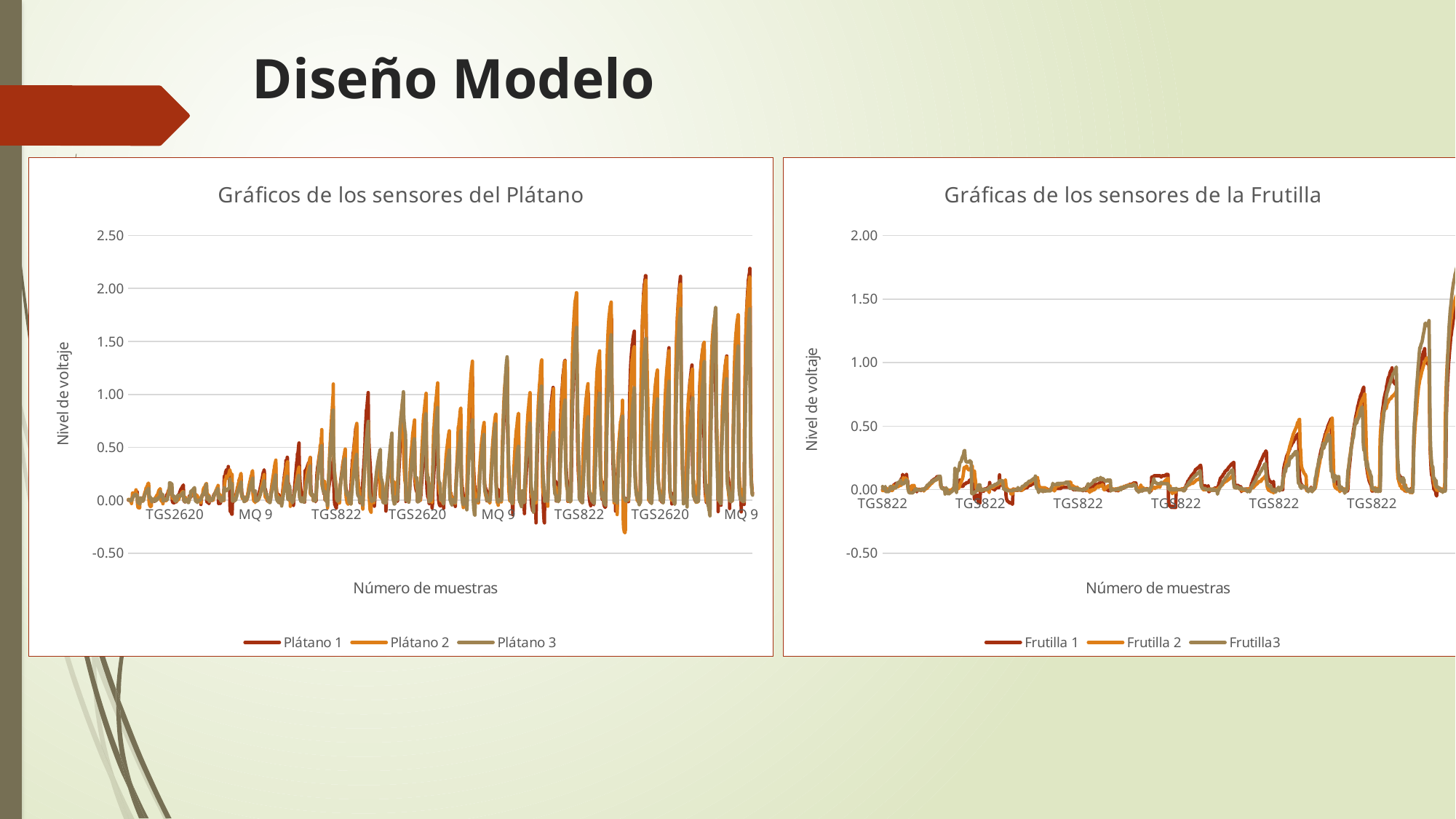
What kind of chart is "Gráficos de los sensores del Plátano"? line chart How many series does the legend of "Gráficas de los sensores de la Frutilla" list? 3 In "Gráficos de los sensores del Plátano", do the peak values generally rise or fall from left to right along the x axis? rise What kind of chart is "Gráficas de los sensores de la Frutilla"? line chart How many series does the legend of "Gráficos de los sensores del Plátano" list? 3 In "Gráficas de los sensores de la Frutilla", do the peak values generally rise or fall from left to right along the x axis? rise In "Gráficas de los sensores de la Frutilla", is the highest peak reached by the lines greater or less than 1.50? greater What are the legend entries of the chart on the right? Frutilla 1, Frutilla 2, Frutilla3 In "Gráficas de los sensores de la Frutilla", are the peaks in the left half of the chart greater or less than 0.50? less In "Gráficos de los sensores del Plátano", is the highest peak reached by the lines greater or less than 2.00? greater What is the y-axis label of the chart on the left? Nivel de voltaje